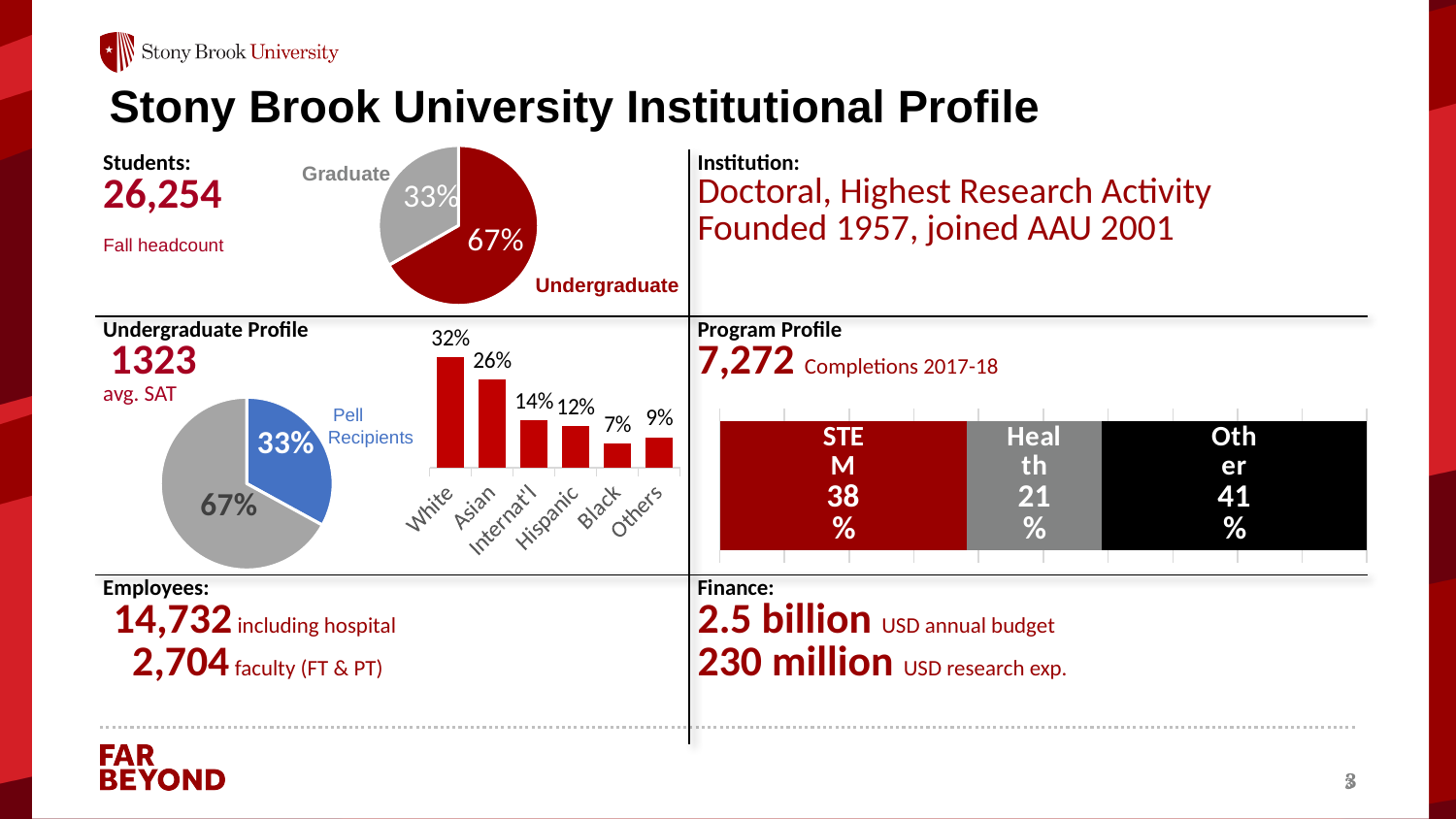
In the Program Profile stacked bar, what is the value for Health? 21% In the Undergraduate Profile bar chart, which category has the lowest value? Black In the Program Profile stacked bar, which segment is larger, STEM or Other? Other In the Undergraduate Profile bar chart, what is the difference between White and Asian? 6% In the Undergraduate Profile bar chart, what is the value for Hispanic? 12% In the Undergraduate Profile bar chart, which category has the highest value? White How many categories are shown in the Undergraduate Profile bar chart? 6 In the Undergraduate Profile pie chart, what share is Pell Recipients? 33% What kind of chart shows the Graduate and Undergraduate split in the Students section? pie chart In the Students pie chart at the top left, what share is Graduate? 33% In the Undergraduate Profile bar chart, what is the value for White? 32% In the Students pie chart at the top left, what share is Undergraduate? 67%